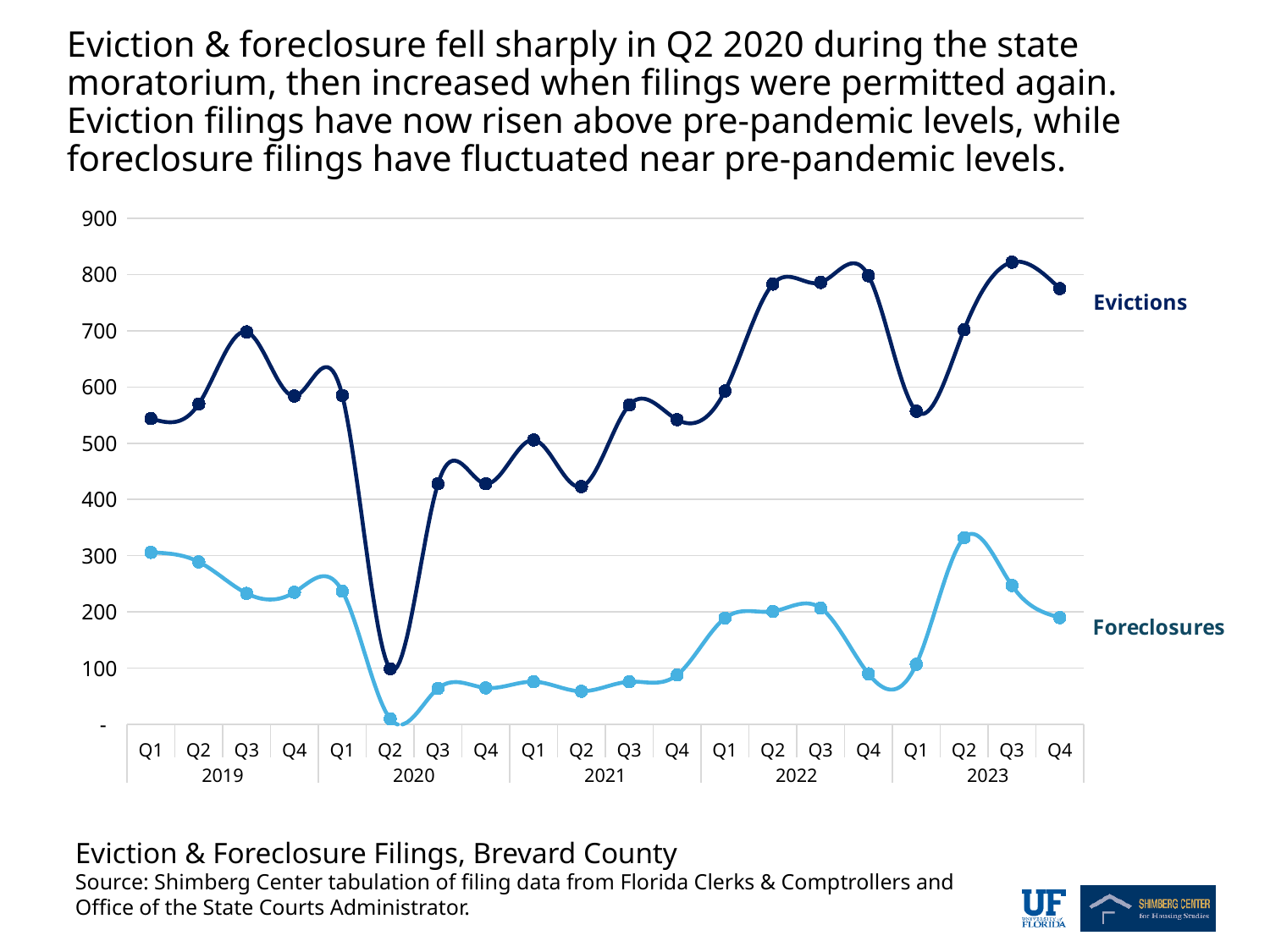
Do Foreclosures rise or fall from Q1 2019 to Q3 2019? fall Is the value for Evictions in Q2 2022 greater or less than 700? greater Which is larger, Evictions in Q3 2019 or Evictions in Q4 2019? Q3 2019 Is the value for Foreclosures in Q2 2023 greater or less than 300? greater What is the title of the chart? Eviction & Foreclosure Filings, Brevard County In which quarter do Foreclosures reach their highest value? Q2 2023 Is the value for Evictions in Q2 2020 greater or less than 200? less How many quarterly data points does each series have? 20 In which quarter do Foreclosures reach their lowest value? Q2 2020 In which quarter do Evictions reach their lowest value? Q2 2020 What kind of chart is shown on the slide? line chart How many series are plotted on the chart? 2